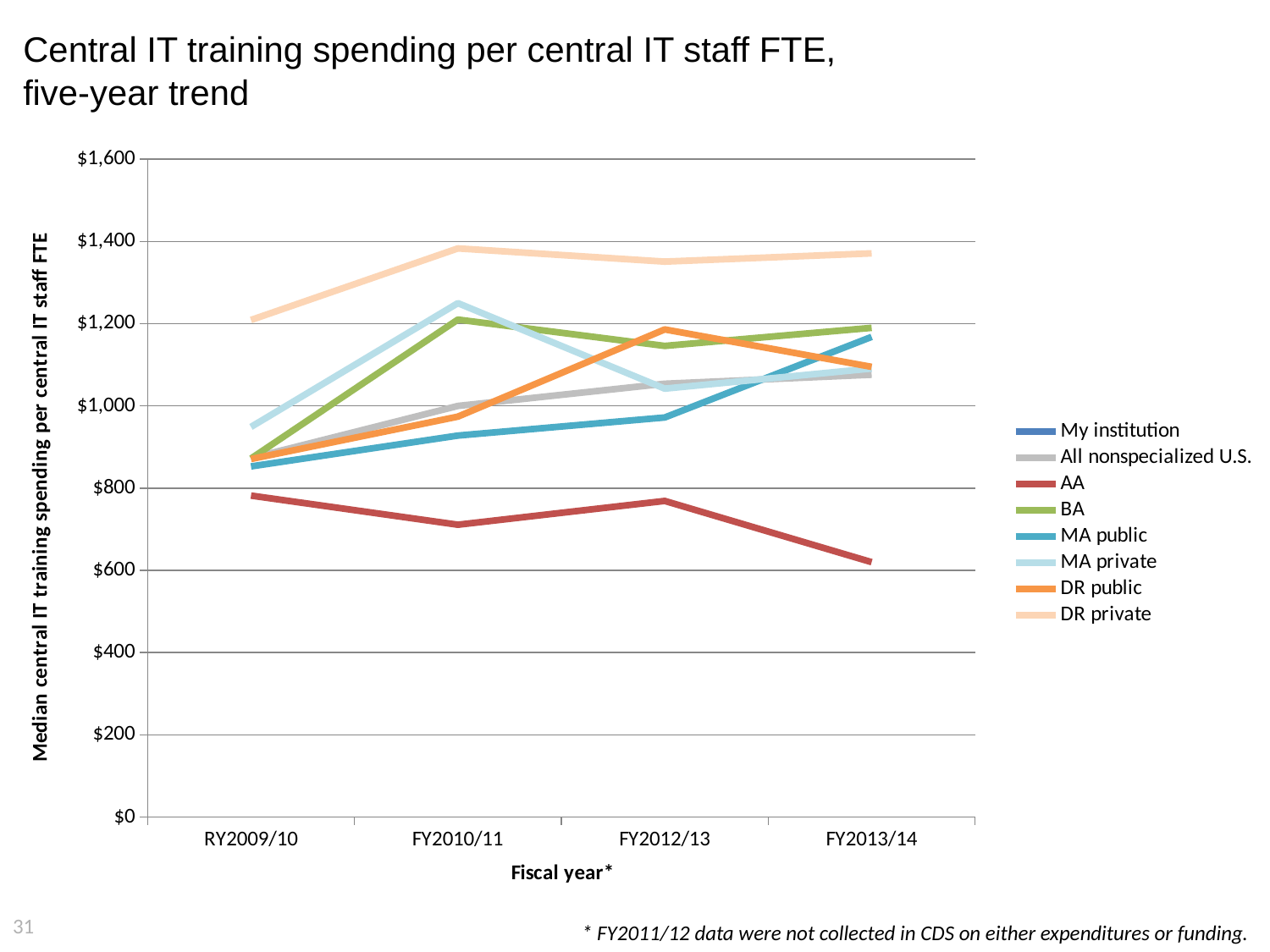
Is the value for MA public in RY2009/10 greater or less than $1,000? less Which series has the lowest value in FY2013/14? AA How many fiscal years are shown on the x axis? 4 Does the AA line end higher or lower in FY2013/14 than it started in RY2009/10? lower How many series does the legend list? 8 Is the value for DR private in FY2010/11 greater or less than $1,200? greater Which series has the highest value in FY2013/14? DR private What is the title of the x axis? Fiscal year* Which is larger in FY2010/11, BA or MA public? BA What kind of chart is shown on the slide? line chart Is the value for AA in FY2013/14 greater or less than $800? less Which series has the highest value in RY2009/10? DR private